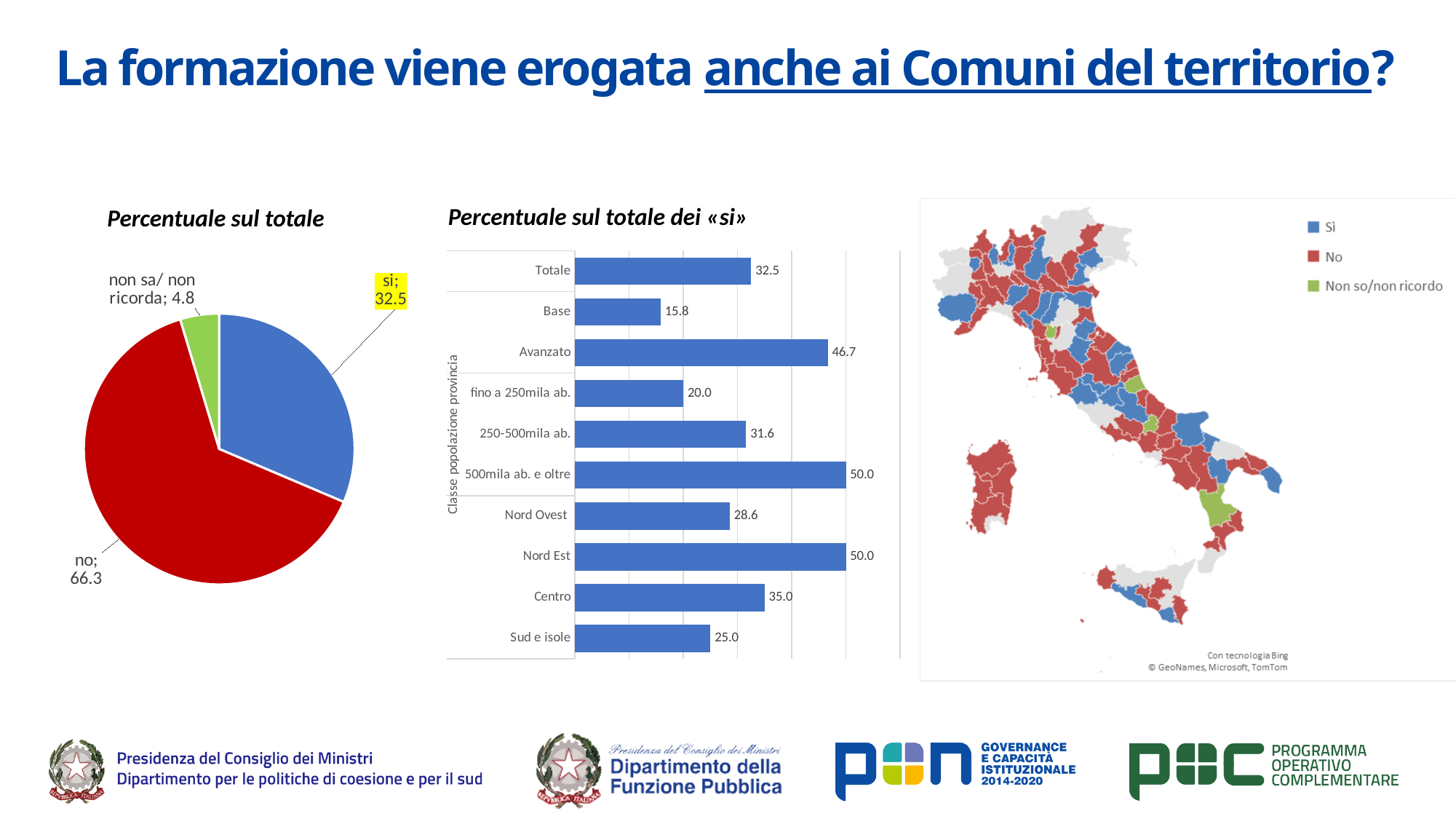
In the bar chart 'Percentuale sul totale dei «si»', which category has the lowest value? Base In the bar chart 'Percentuale sul totale dei «si»', what is the y-axis title? Classe popolazione provincia In the bar chart 'Percentuale sul totale dei «si»', what is the value for 'Nord Ovest'? 28.6 In the bar chart 'Percentuale sul totale dei «si»', what is the value for 'Avanzato'? 46.7 In the bar chart 'Percentuale sul totale dei «si»', what is the difference between 'Avanzato' and 'Base'? 30.9 In the bar chart 'Percentuale sul totale dei «si»', which is larger, 'Centro' or 'Sud e isole'? Centro In the pie chart 'Percentuale sul totale', how many slices are there? 3 What type of chart is 'Percentuale sul totale dei «si»'? bar chart In the pie chart 'Percentuale sul totale', what is the value for 'non sa/ non ricorda'? 4.8 In the pie chart 'Percentuale sul totale', which slice is the largest? no In the bar chart 'Percentuale sul totale dei «si»', how many categories are shown? 10 In the pie chart 'Percentuale sul totale', what is the value for 'no'? 66.3